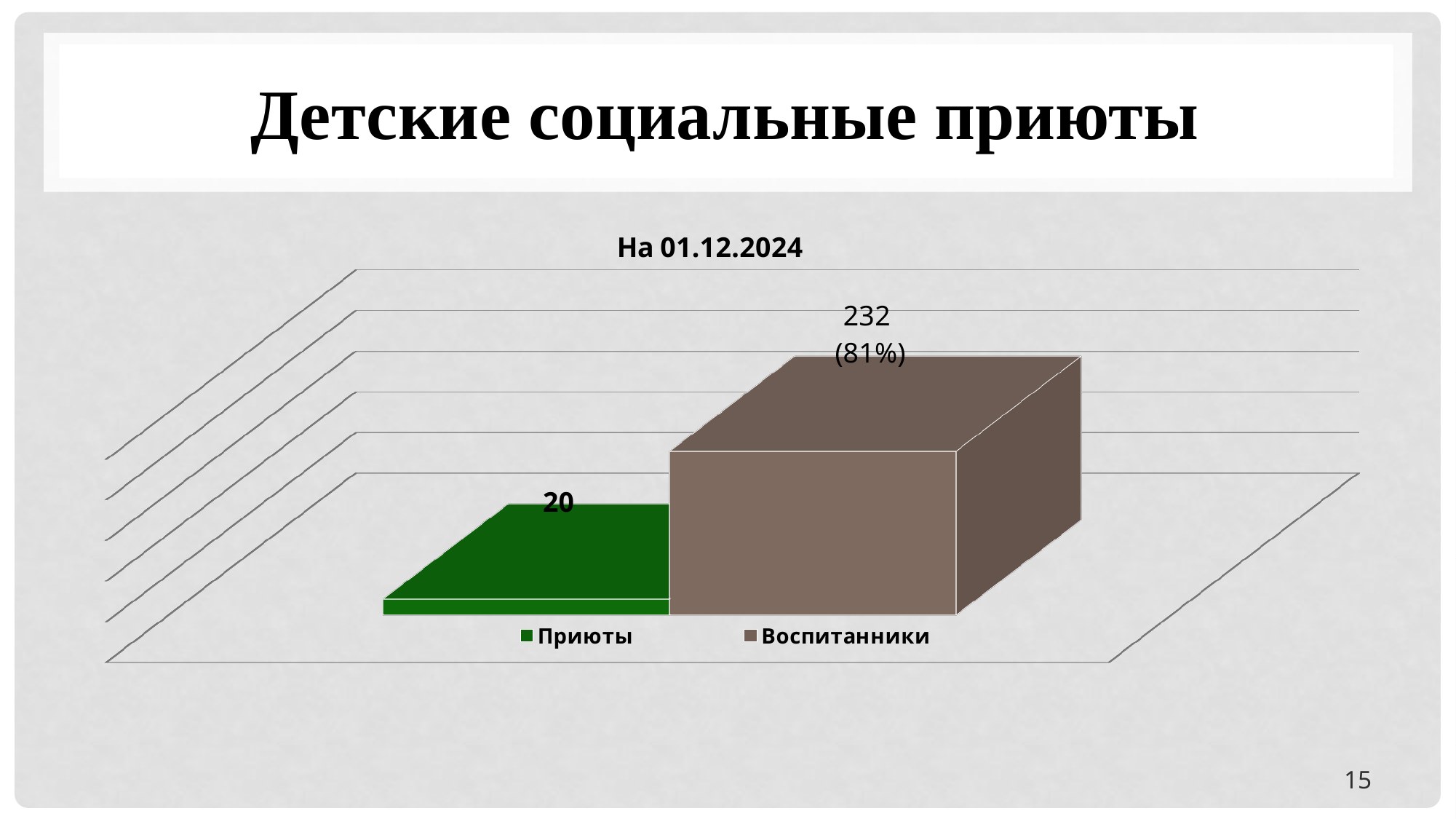
What colour is the bar for Приюты? green What kind of chart is shown on the slide? bar chart How many series does the legend list? 2 What percentage is shown next to the value for Воспитанники? 81% What is the value for Воспитанники? 232 (81%) What is the title of the chart? На 01.12.2024 What is the difference between the values for Воспитанники and Приюты? 212 What is the value for Приюты? 20 Which series has the lowest value? Приюты Which series has the higher value, Приюты or Воспитанники? Воспитанники